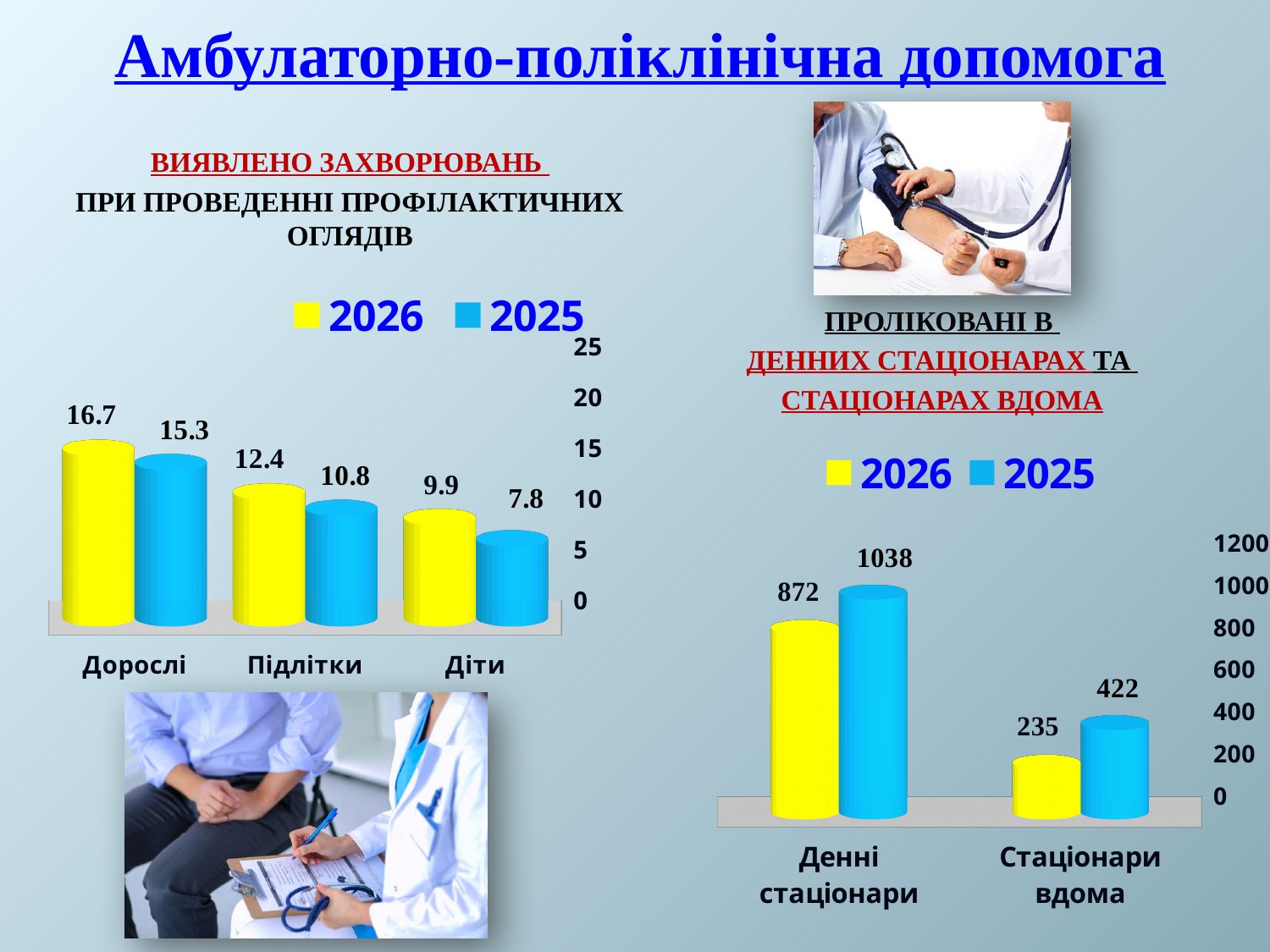
In the right chart (Проліковані в денних стаціонарах та стаціонарах вдома), what is the 2025 value for Денні стаціонари? 1038 In the left chart, what is the 2025 value for Діти? 7.8 In the right chart, what is the difference between the 2025 and 2026 values for Стаціонари вдома? 187 In the left chart, which category has the highest 2026 value? Дорослі In the left chart, do the 2026 values rise or fall from Дорослі to Діти? fall In the left chart, what is the difference between the 2026 and 2025 values for Підлітки? 1.6 How many series does the legend of the right chart list? 2 In the left chart, how many categories are shown on the x axis? 3 In the left chart (Виявлено захворювань при проведенні профілактичних оглядів), what is the 2026 value for Дорослі? 16.7 In the right chart, what is the 2026 value for Стаціонари вдома? 235 In the right chart, which is larger for Денні стаціонари: the 2026 value or the 2025 value? 2025 In the left chart, which category has the lowest 2025 value? Діти